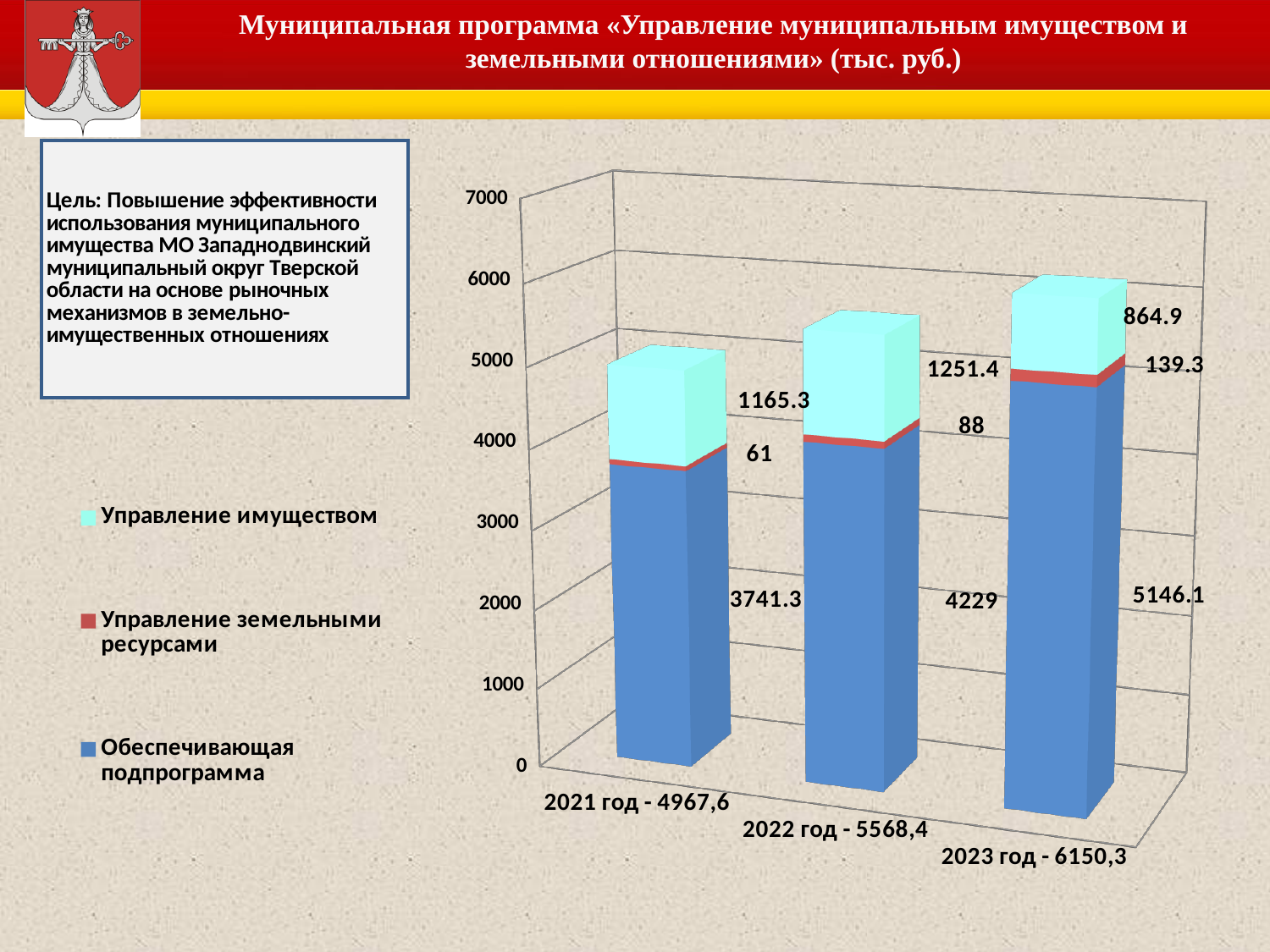
What is the value of Управление земельными ресурсами for 2023 год? 139.3 How many categories (years) are plotted on the x axis? 3 In which year is the value of Управление имуществом the lowest? 2023 год Which is larger: Управление земельными ресурсами for 2022 год or for 2021 год? 2022 год How many series does the legend list? 3 Does the value of Обеспечивающая подпрограмма rise or fall from 2021 to 2023? rise What is the value of Обеспечивающая подпрограмма for 2021 год? 3741.3 What is the difference between the Обеспечивающая подпрограмма values for 2023 год and 2022 год? 917.1 What is the value of Управление имуществом for 2022 год? 1251.4 In which year is the value of Обеспечивающая подпрограмма the highest? 2023 год What is the total of the stacked bar for 2022 год? 5568,4 What kind of chart is shown on the slide? stacked bar chart